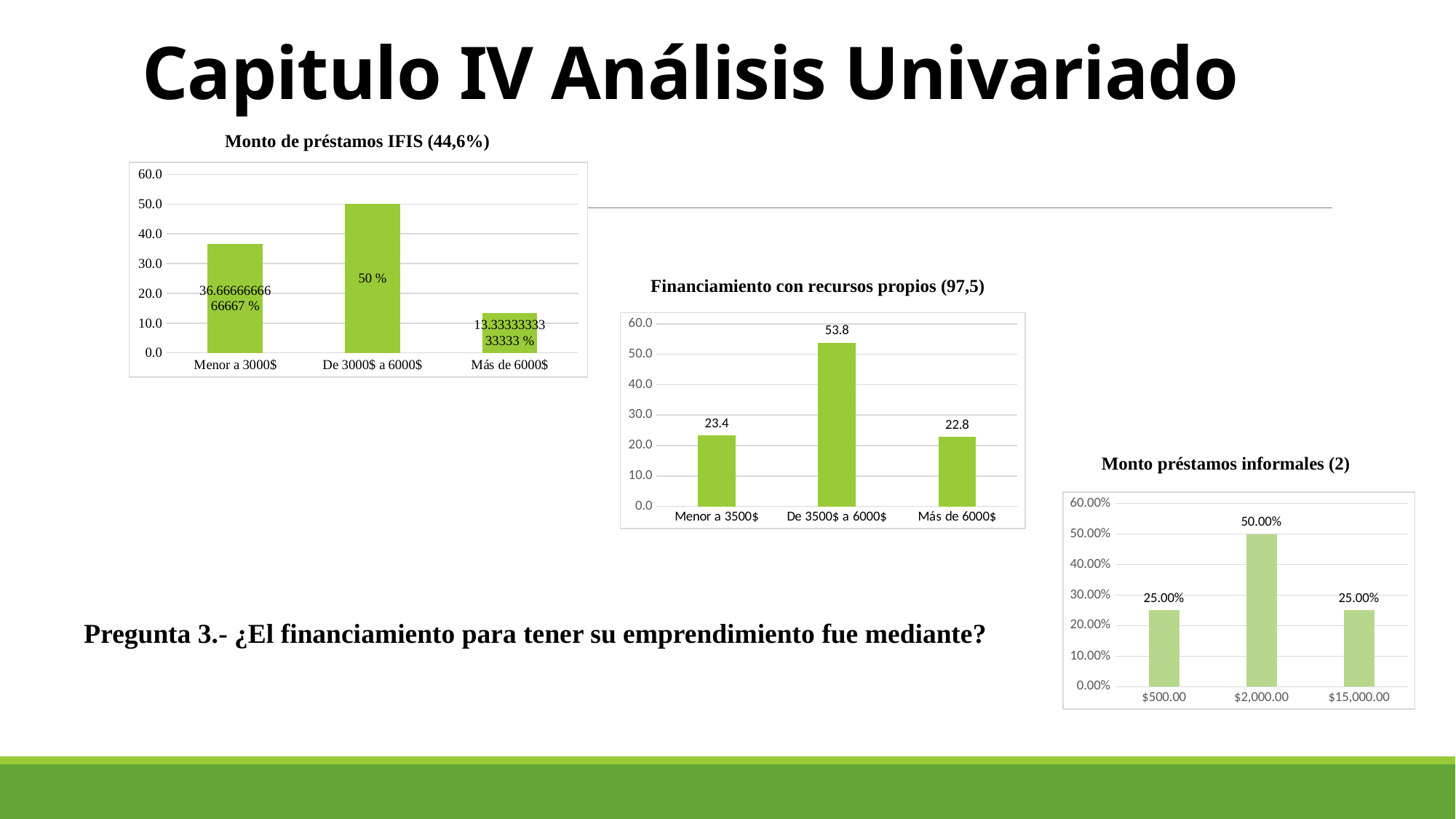
In the chart titled 'Financiamiento con recursos propios (97,5)', which category has the lowest value? Más de 6000$ In the chart titled 'Monto de préstamos IFIS (44,6%)', is the value for 'Más de 6000$' greater or less than 20.0? less In the chart titled 'Monto préstamos informales (2)', how many categories are shown on the x axis? 3 In the chart titled 'Financiamiento con recursos propios (97,5)', what is the value for 'Menor a 3500$'? 23.4 In the chart titled 'Monto préstamos informales (2)', what is the value for '$2,000.00'? 50.00% What kind of chart is the one titled 'Financiamiento con recursos propios (97,5)'? bar chart In the chart titled 'Financiamiento con recursos propios (97,5)', what is the value for 'De 3500$ a 6000$'? 53.8 In the chart titled 'Monto préstamos informales (2)', which category has the highest value? $2,000.00 How many charts are shown on the slide? 3 In the chart titled 'Monto de préstamos IFIS (44,6%)', what is the value for 'De 3000$ a 6000$'? 50 % In the chart titled 'Monto de préstamos IFIS (44,6%)', which category has the highest value? De 3000$ a 6000$ In the chart titled 'Financiamiento con recursos propios (97,5)', what is the difference between the values for 'De 3500$ a 6000$' and 'Más de 6000$'? 31.0